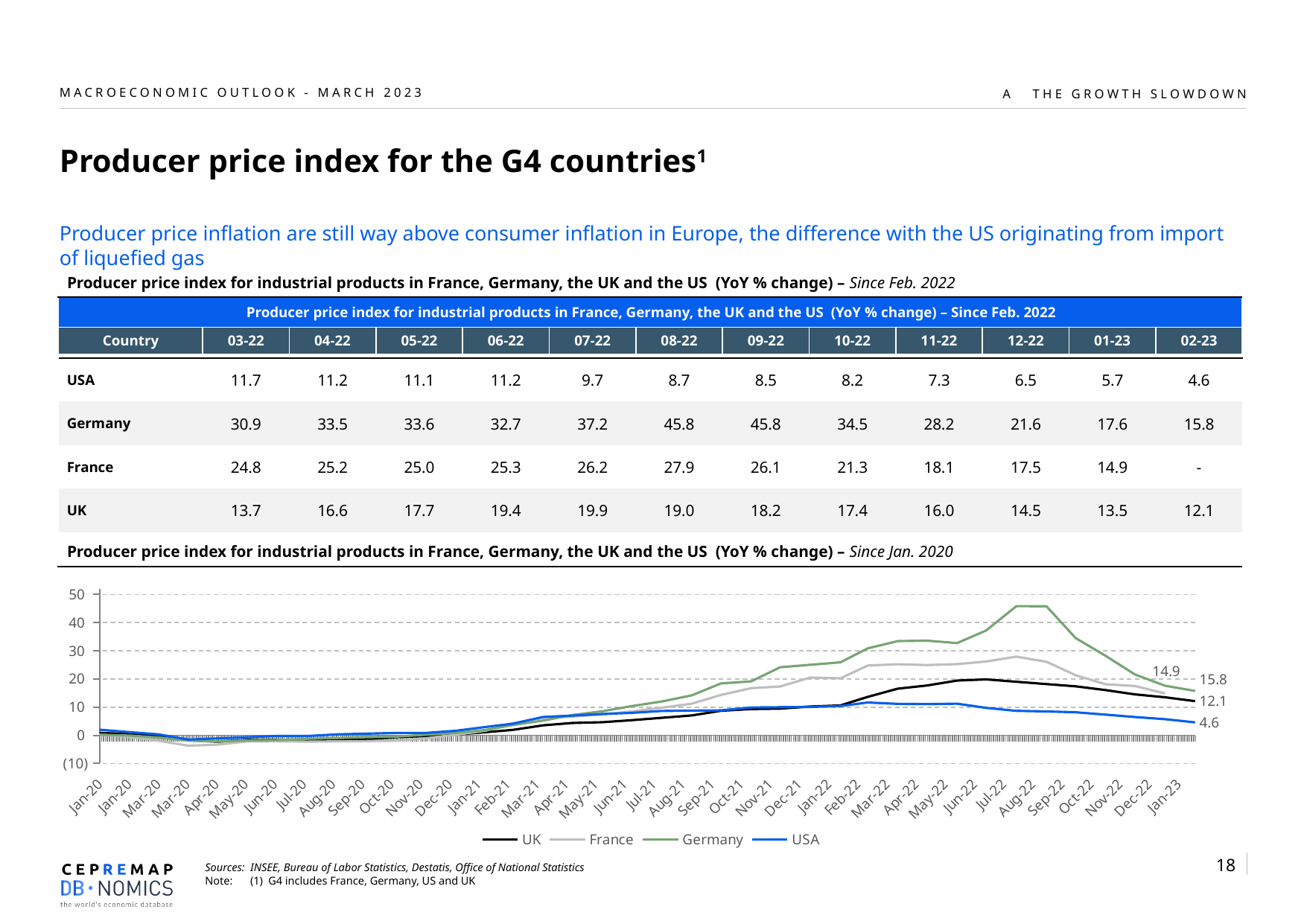
In the line chart, which country has the lowest value at the end of the series? USA What kind of chart is shown at the bottom of the slide? line chart How many series does the legend of the line chart list? 4 In the line chart, which country has the highest value at the end of the series? Germany In the line chart, is the peak value for Germany around Aug-22 greater or less than 40? greater In the line chart, what is the final labelled value for Germany? 15.8 In the line chart, does the Germany series rise or fall between Aug-22 and Jan-23? fall In the line chart, what is the final labelled value for the USA? 4.6 In the line chart, what is the difference between the final labelled values for Germany and the USA? 11.2 In the line chart, is the final value for Germany or the UK larger? Germany In the line chart, which colour is used for the Germany series? green In the line chart, what is the final labelled value for the UK? 12.1